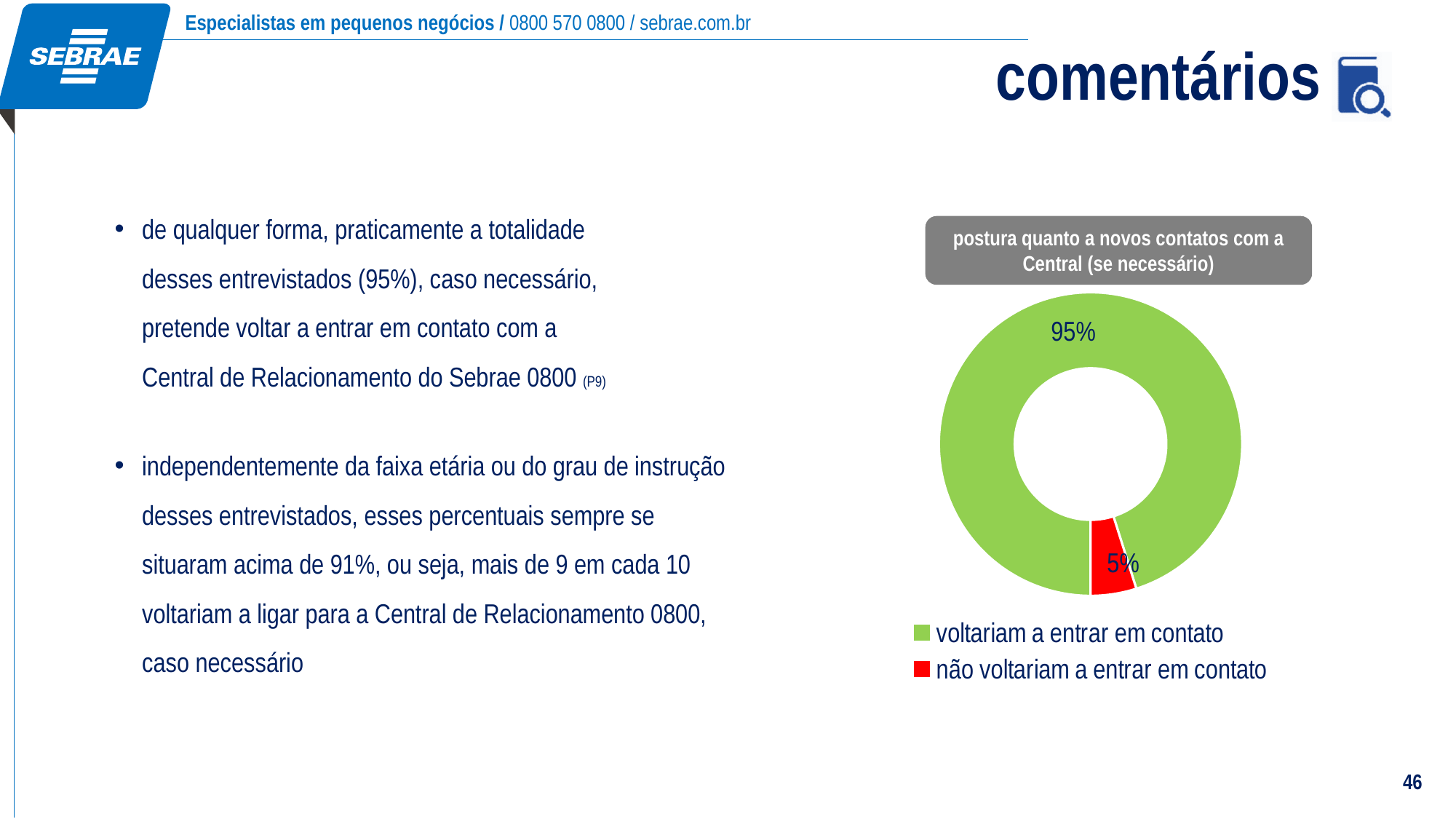
What is the total of the two shares shown in the chart? 100% How many entries does the chart legend list? 2 What share of respondents would not contact the Central again ("não voltariam a entrar em contato")? 5% What share of respondents would contact the Central again ("voltariam a entrar em contato")? 95% What is the title of the chart? postura quanto a novos contatos com a Central (se necessário) Which is larger: the share that would contact again or the share that would not? voltariam a entrar em contato Which category has the largest share in the chart? voltariam a entrar em contato What kind of chart is shown on the slide? Doughnut (pie) chart What is the difference in percentage points between the share that would contact again and the share that would not? 90 percentage points What colour represents "não voltariam a entrar em contato" in the chart? Red How many categories are shown in the chart? 2 Which category has the smallest share in the chart? não voltariam a entrar em contato